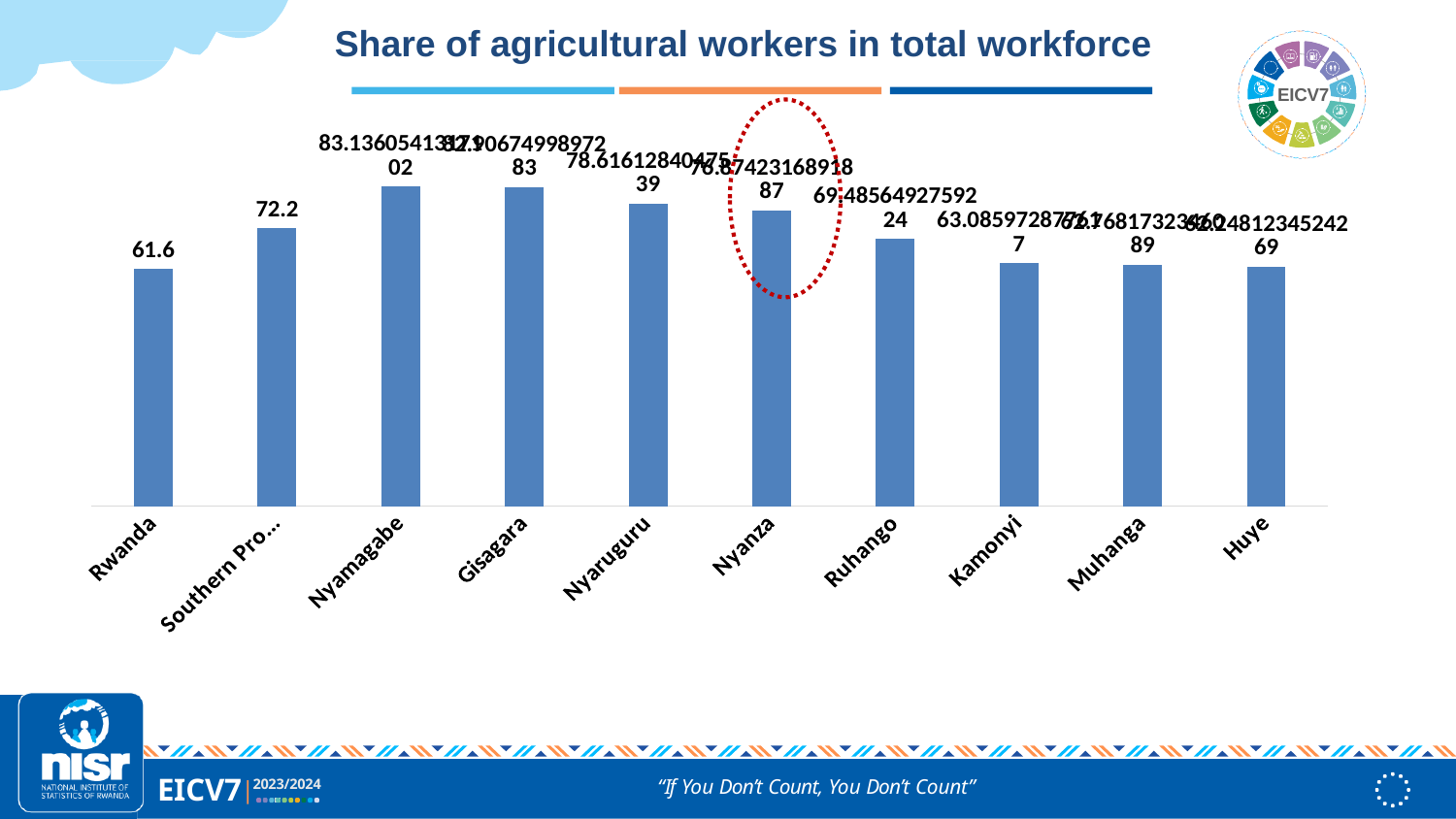
What is the difference between the values for Southern Pro... and Rwanda? 10.6 What type of chart is shown on the slide? bar chart What is the value for Southern Pro...? 72.2 What is the title of the chart? Share of agricultural workers in total workforce Which category has the highest value? Nyamagabe Which category's bar is highlighted with a red dotted circle? Nyanza Which is larger, the value for Nyamagabe or the value for Huye? Nyamagabe Which category has the lowest value? Rwanda What is the value for Rwanda? 61.6 How many categories are shown on the x axis? 10 Which is larger, the value for Gisagara or the value for Kamonyi? Gisagara Which is larger, the value for Rwanda or the value for Nyaruguru? Nyaruguru